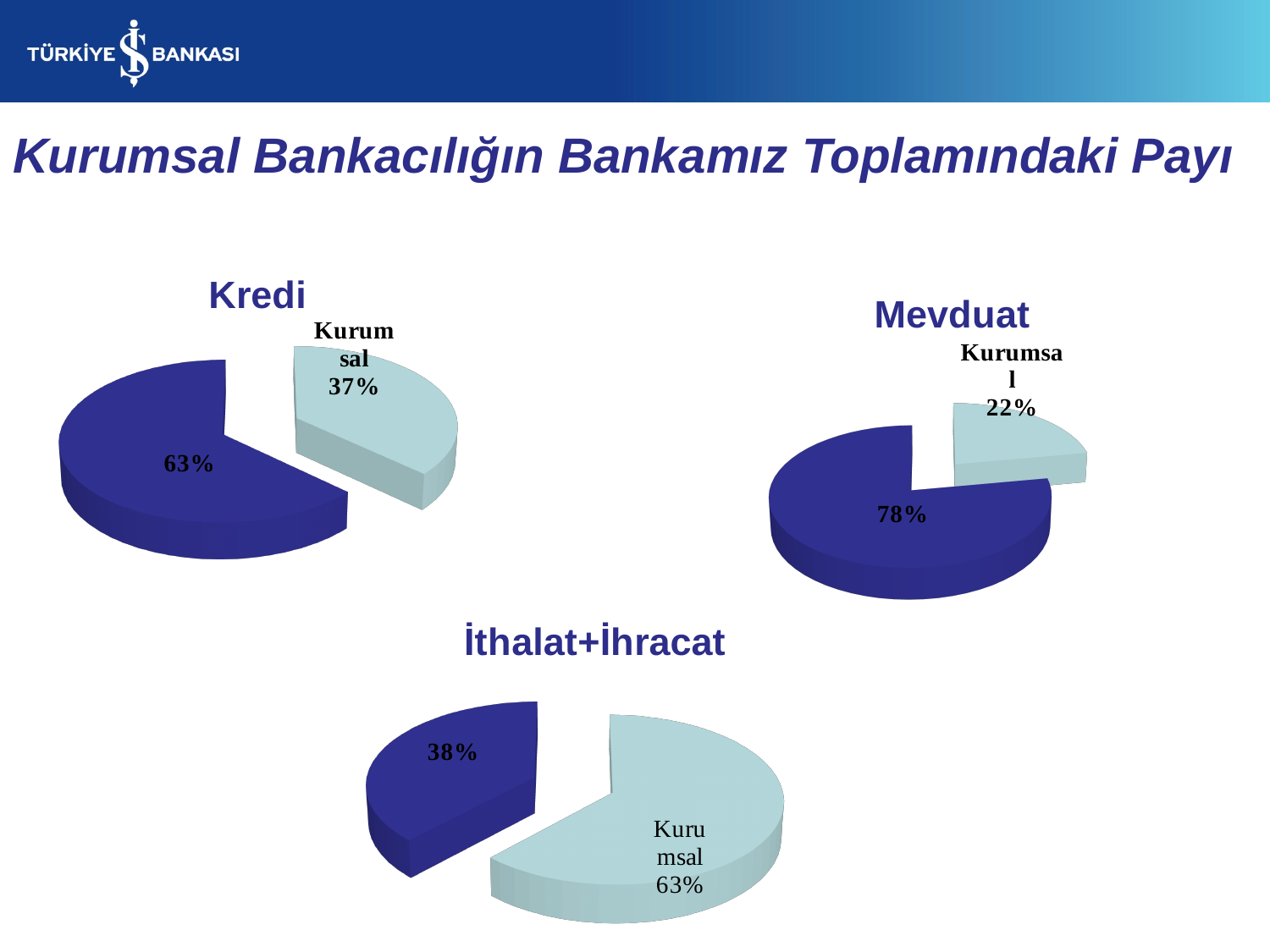
How many slices does the Mevduat pie chart have? 2 How many pie charts are shown on the slide? 3 In the Mevduat pie chart, what share does the Kurumsal slice have? 22% In the Kredi pie chart, what percentage is shown on the larger, dark blue slice? 63% In the İthalat+İhracat pie chart, what share does the Kurumsal slice have? 63% What type of chart is used for Kredi, Mevduat and İthalat+İhracat on this slide? Pie chart Which chart on the slide shows the smallest Kurumsal share: Kredi, Mevduat or İthalat+İhracat? Mevduat Which chart on the slide shows the largest Kurumsal share: Kredi, Mevduat or İthalat+İhracat? İthalat+İhracat What is the difference between the Kurumsal share in the Kredi chart and the Kurumsal share in the Mevduat chart? 15% In the Kredi pie chart, what share does the Kurumsal slice have? 37% In the İthalat+İhracat pie chart, what percentage is shown on the dark blue slice? 38% In the Mevduat pie chart, what percentage is shown on the larger, dark blue slice? 78%